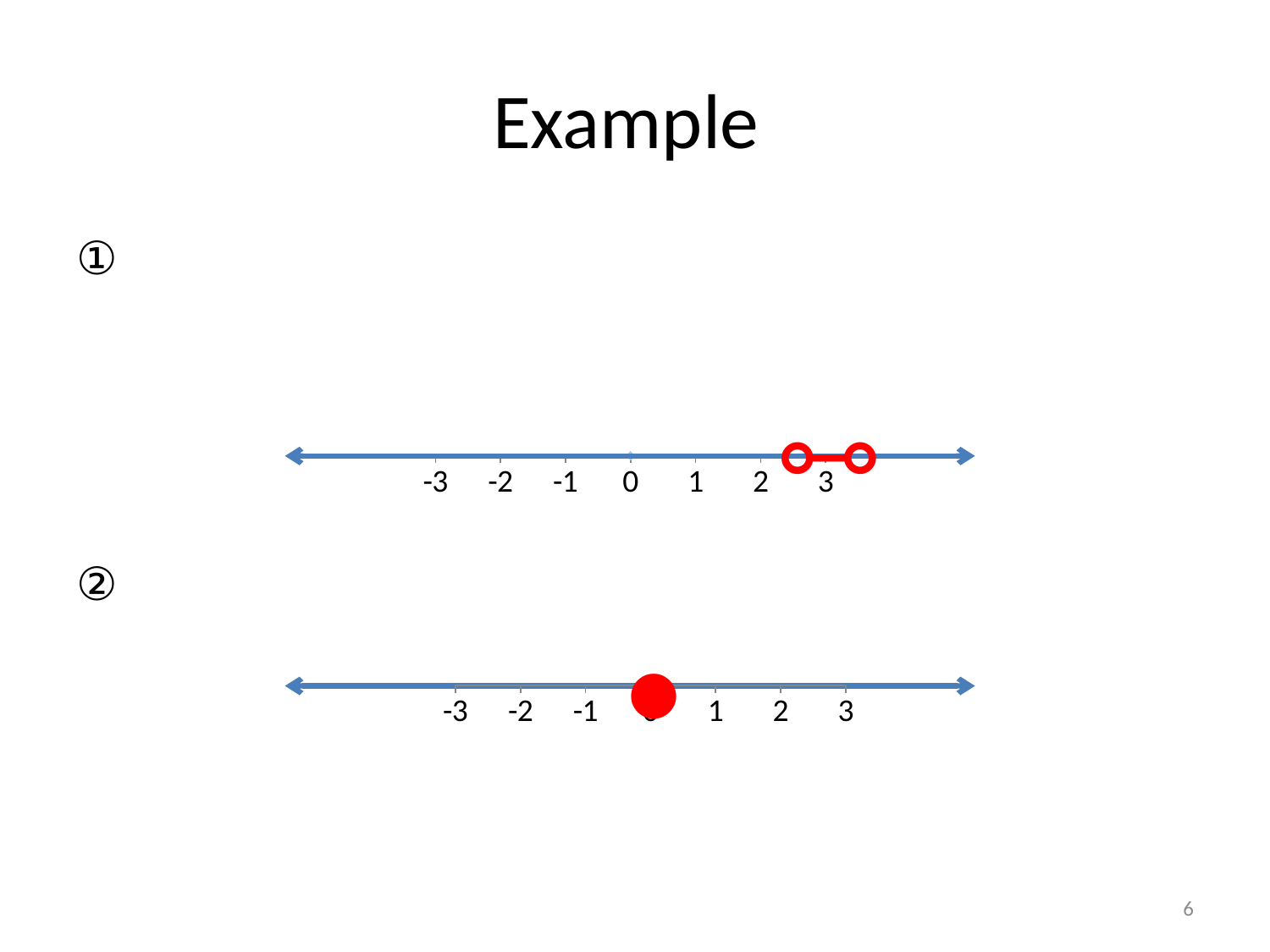
On the second number line (②), what is the largest labeled value? 3 On the first number line (①), are the red circles at the ends of the segment open or filled? open On the first number line (①), how many tick marks are labeled with numbers? 7 On the first number line (①), what is the smallest labeled value? -3 On the second number line (②), is the filled red dot located at a value greater or less than 1? less On the second number line (②), what is the smallest labeled value? -3 On the second number line (②), how many tick marks are labeled with numbers? 7 On the first number line (①), is the red segment located at values greater or less than 2? greater How many number lines are shown on the slide? 2 On the second number line (②), is the red dot open or filled? filled On the first number line (①), what is the largest labeled value? 3 On the second number line (②), at which labeled value is the filled red dot placed? 0